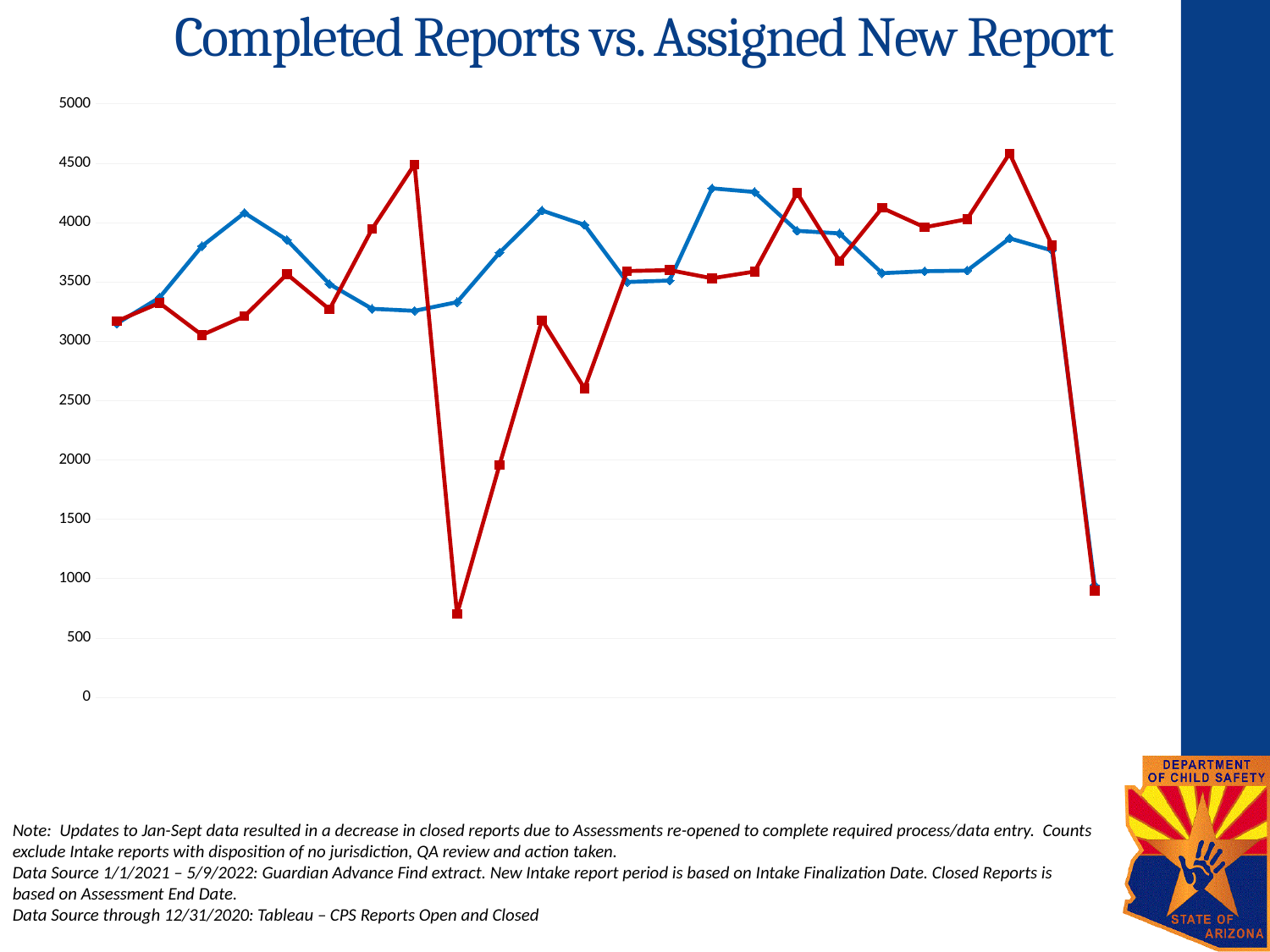
What colours are the two lines on the chart? blue and red What is the maximum value shown on the vertical axis? 5000 Is the lowest point of the red line greater or less than 1000? less Is the highest point of the blue line greater or less than 4000? greater Which line reaches the lowest value on the chart, the red line or the blue line? red line What type of chart is shown on the slide? line chart Is the highest point of the red line greater or less than 4000? greater What is the title of the chart? Completed Reports vs. Assigned New Report Which line reaches the highest value on the chart, the red line or the blue line? red line How many lines (series) are plotted on the chart? 2 Do both lines rise or fall sharply at the final point on the right of the chart? fall